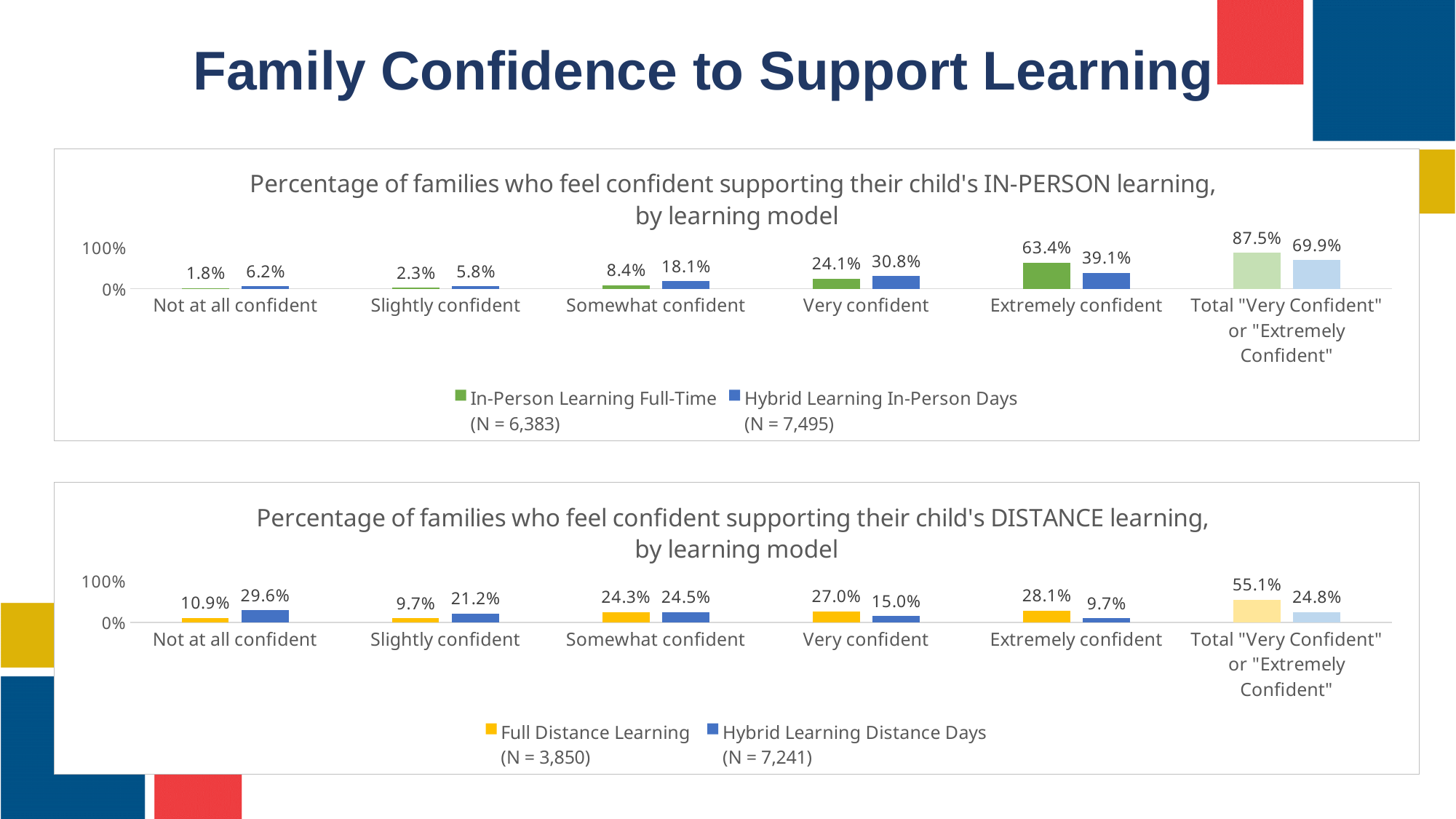
In the DISTANCE learning chart, what is the value for Full Distance Learning at Very confident? 27.0% In the IN-PERSON learning chart, which category has the highest value for In-Person Learning Full-Time? Total "Very Confident" or "Extremely Confident" How many series does the legend of the DISTANCE learning chart list? 2 How many categories are shown on the x axis of the IN-PERSON learning chart? 6 In the DISTANCE learning chart, which series has the larger value at Slightly confident? Hybrid Learning Distance Days In the IN-PERSON learning chart, what is the value for Hybrid Learning In-Person Days at Somewhat confident? 18.1% In the IN-PERSON learning chart, what is the difference between In-Person Learning Full-Time and Hybrid Learning In-Person Days at Extremely confident? 24.3% In the DISTANCE learning chart, what is the difference between Full Distance Learning and Hybrid Learning Distance Days for Total "Very Confident" or "Extremely Confident"? 30.3% In the IN-PERSON learning chart, what is the value for In-Person Learning Full-Time at Extremely confident? 63.4% In the DISTANCE learning chart, what is the value for Hybrid Learning Distance Days at Not at all confident? 29.6% In the DISTANCE learning chart, which category has the lowest value for Hybrid Learning Distance Days? Extremely confident What kind of chart is the IN-PERSON learning chart? Bar chart